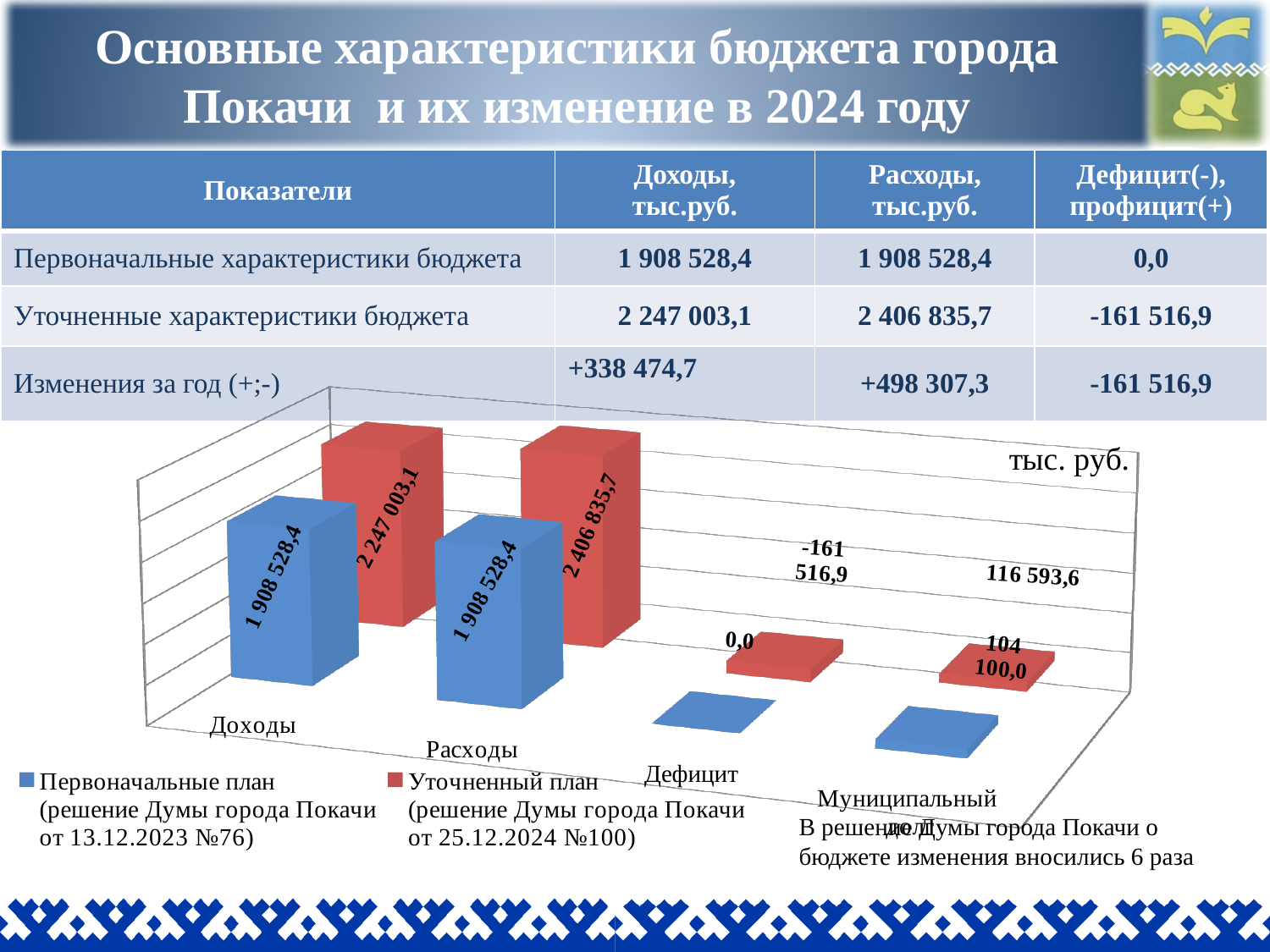
What is the value of the Первоначальные план series for Дефицит in the chart? 0,0 What unit is indicated in the top right corner of the chart? тыс. руб. What is the difference between the Уточненный план and Первоначальные план values for Расходы? 498 307,3 What is the value of the Первоначальные план series for Расходы in the chart? 1 908 528,4 Which is larger for Расходы: the Первоначальные план value or the Уточненный план value? Уточненный план What is the difference between the Уточненный план and Первоначальные план values for Доходы? 338 474,7 What is the value of the Уточненный план series for Дефицит in the chart? -161 516,9 What is the value of the Уточненный план series for Расходы in the chart? 2 406 835,7 What is the value of the Уточненный план series for Доходы in the chart? 2 247 003,1 Which category has the highest value in the Уточненный план series? Расходы How many series does the chart legend list? 2 What kind of chart is shown on the slide? Bar chart